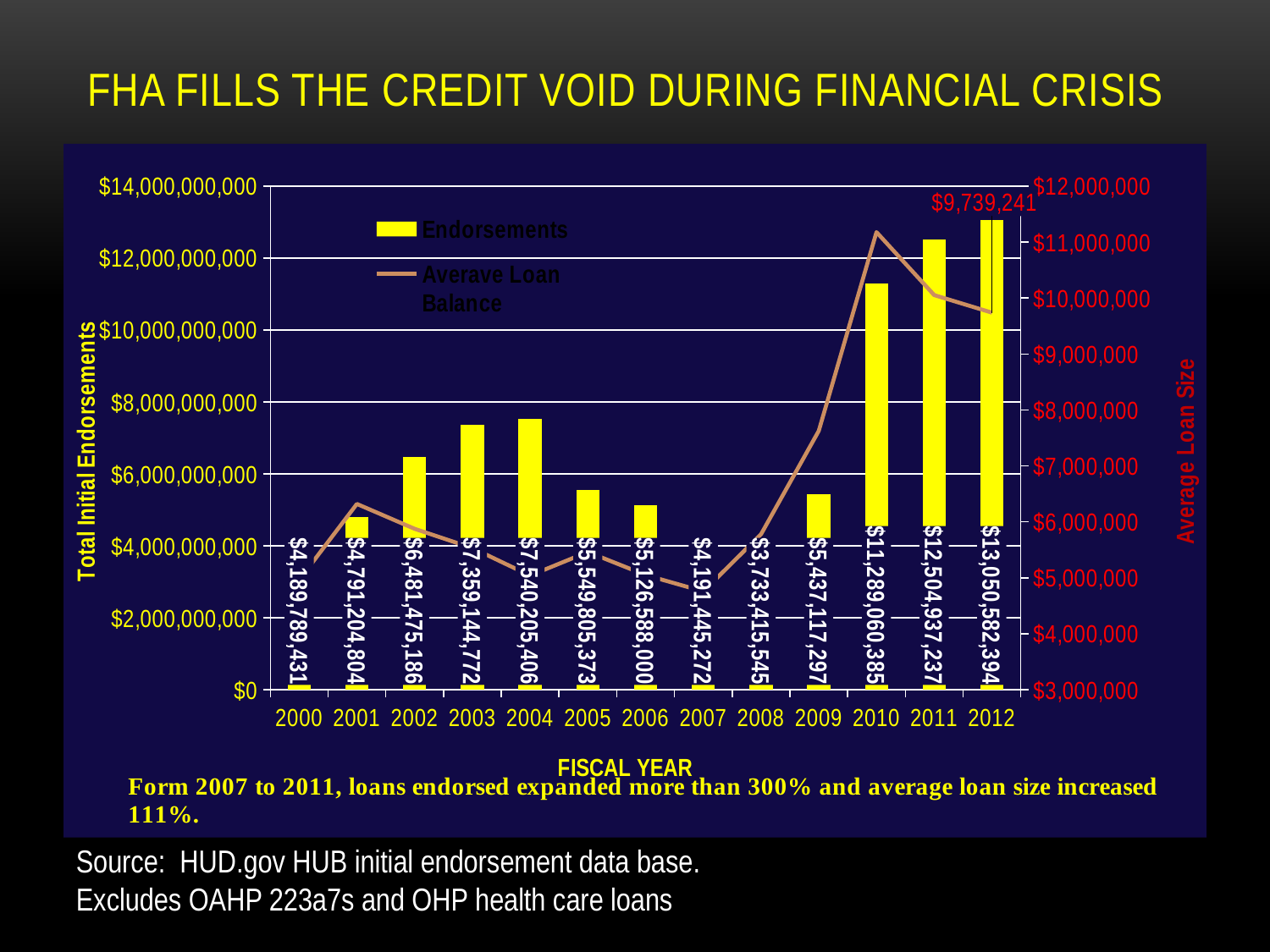
Which fiscal year had the highest total initial endorsements? 2012 Is the average loan balance for fiscal year 2000 greater or less than $6,000,000? less What was the total initial endorsements value for fiscal year 2008? $3,733,415,545 What was the total initial endorsements value for fiscal year 2003? $7,359,144,772 What was the total initial endorsements value for fiscal year 2010? $11,289,060,385 How many series does the chart legend list? 2 Is the average loan balance for fiscal year 2009 greater or less than $7,000,000? greater What is the difference in total initial endorsements between fiscal year 2012 and fiscal year 2011? $545,645,157 Which fiscal year had larger total initial endorsements, 2005 or 2006? 2005 Which fiscal year had the lowest total initial endorsements? 2008 What kind of chart is shown on the slide? Combination bar and line chart How many fiscal years are shown on the x axis of the chart? 13